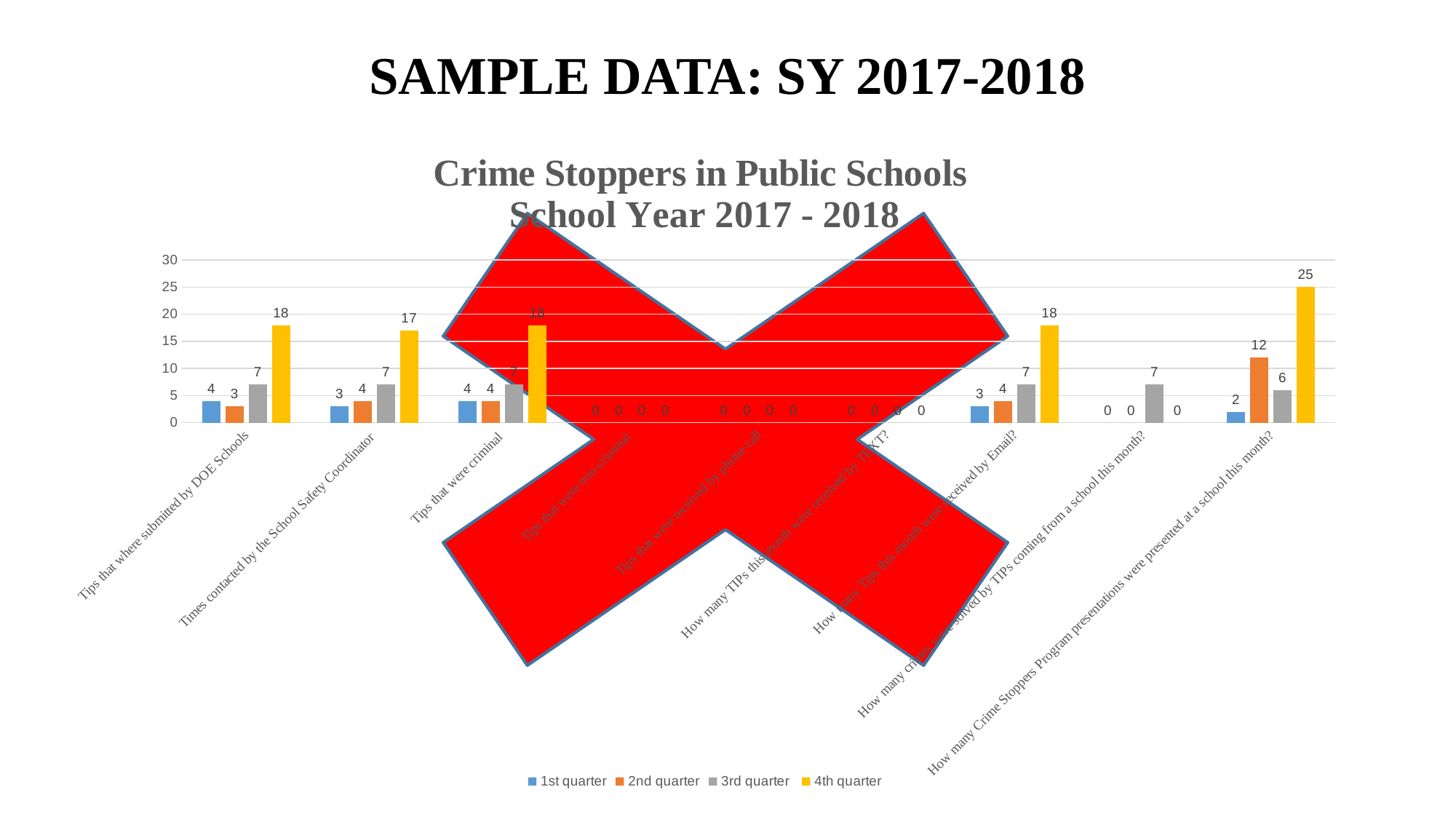
Which quarter has the lowest value for 'How many Crime Stoppers Program presentations were presented at a school this month?'? 1st quarter What is the title of the chart? Crime Stoppers in Public Schools School Year 2017 - 2018 What is the difference between the 4th quarter and 3rd quarter values for 'Times contacted by the School Safety Coordinator'? 10 What type of chart is shown on the slide? bar chart What is the total of the four quarter values for 'Tips that were criminal'? 33 Which is larger: the 4th quarter value for 'Tips that where submitted by DOE Schools' or the 4th quarter value for 'Times contacted by the School Safety Coordinator'? Tips that where submitted by DOE Schools What is the 4th quarter value for 'Tips that where submitted by DOE Schools'? 18 What is the 4th quarter value for 'How many Crime Stoppers Program presentations were presented at a school this month?'? 25 What is the 2nd quarter value for 'Times contacted by the School Safety Coordinator'? 4 What is the 2nd quarter value for 'How many Crime Stoppers Program presentations were presented at a school this month?'? 12 Which quarter has the highest value for 'Tips that were criminal'? 4th quarter How many series does the legend list? 4